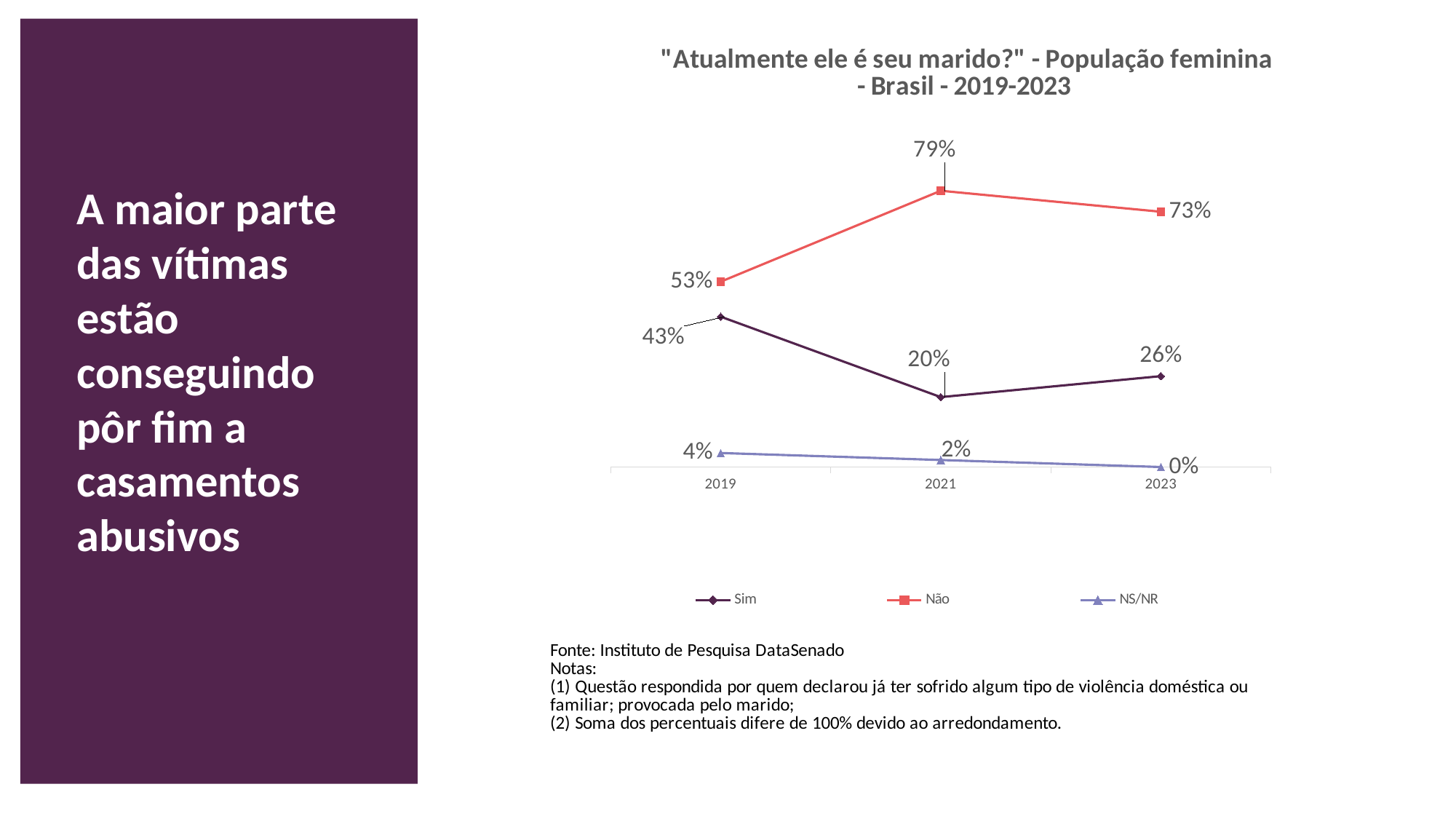
In which year is the "Sim" series lowest? 2021 What kind of chart is shown on the slide? Line chart Does the "NS/NR" series rise or fall from 2019 to 2023? Fall What is the difference between the "Não" value in 2021 and the "Não" value in 2019? 26% What is the value for "Sim" in 2019? 43% In which year is the "Não" series highest? 2021 Which is larger in 2023, the "Sim" value or the "Não" value? Não How many years are shown on the x axis? 3 How many series does the legend list? 3 What is the value for "Sim" in 2023? 26% What is the value for "NS/NR" in 2023? 0% What is the value for "Não" in 2021? 79%